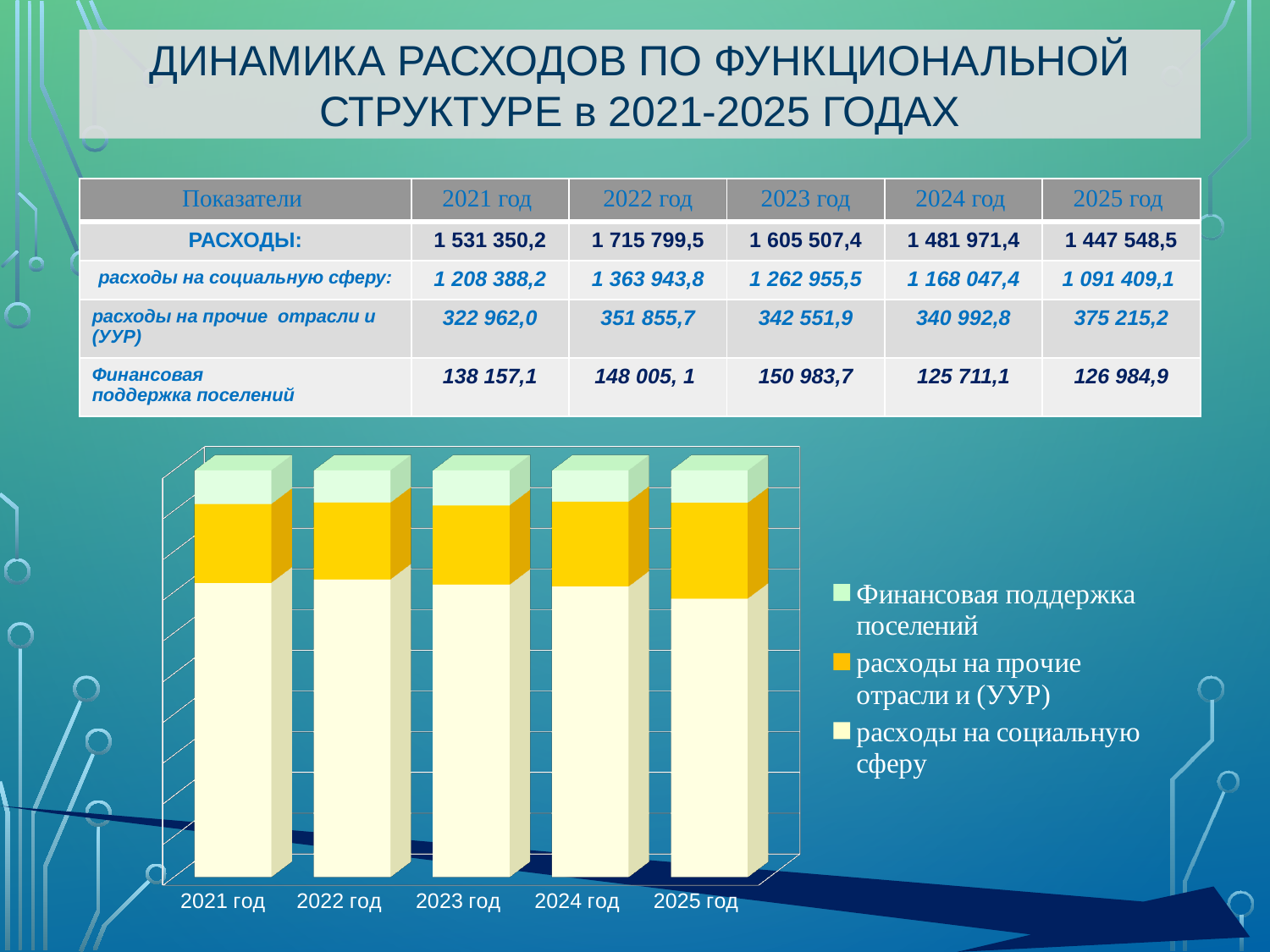
According to the table, what is the value of расходы на социальную сферу for 2022 год? 1 363 943,8 According to the table, in which year are total РАСХОДЫ the highest? 2022 год Which series is shown in light green at the top of each bar? Финансовая поддержка поселений According to the table, by how much do total РАСХОДЫ in 2022 год exceed those in 2021 год? 184 449,3 According to the table, in which year are расходы на социальную сферу the lowest? 2025 год What is the label of the first category on the x axis of the chart? 2021 год What kind of chart is shown on the slide? Stacked bar chart How many series does the chart legend list? 3 How many years (categories) are plotted along the x axis of the chart? 5 Which series is shown in yellow in the middle of each bar? расходы на прочие отрасли и (УУР) According to the table, what is the value of Финансовая поддержка поселений for 2023 год? 150 983,7 According to the table, which year has the larger value for расходы на прочие отрасли и (УУР): 2021 год or 2025 год? 2025 год